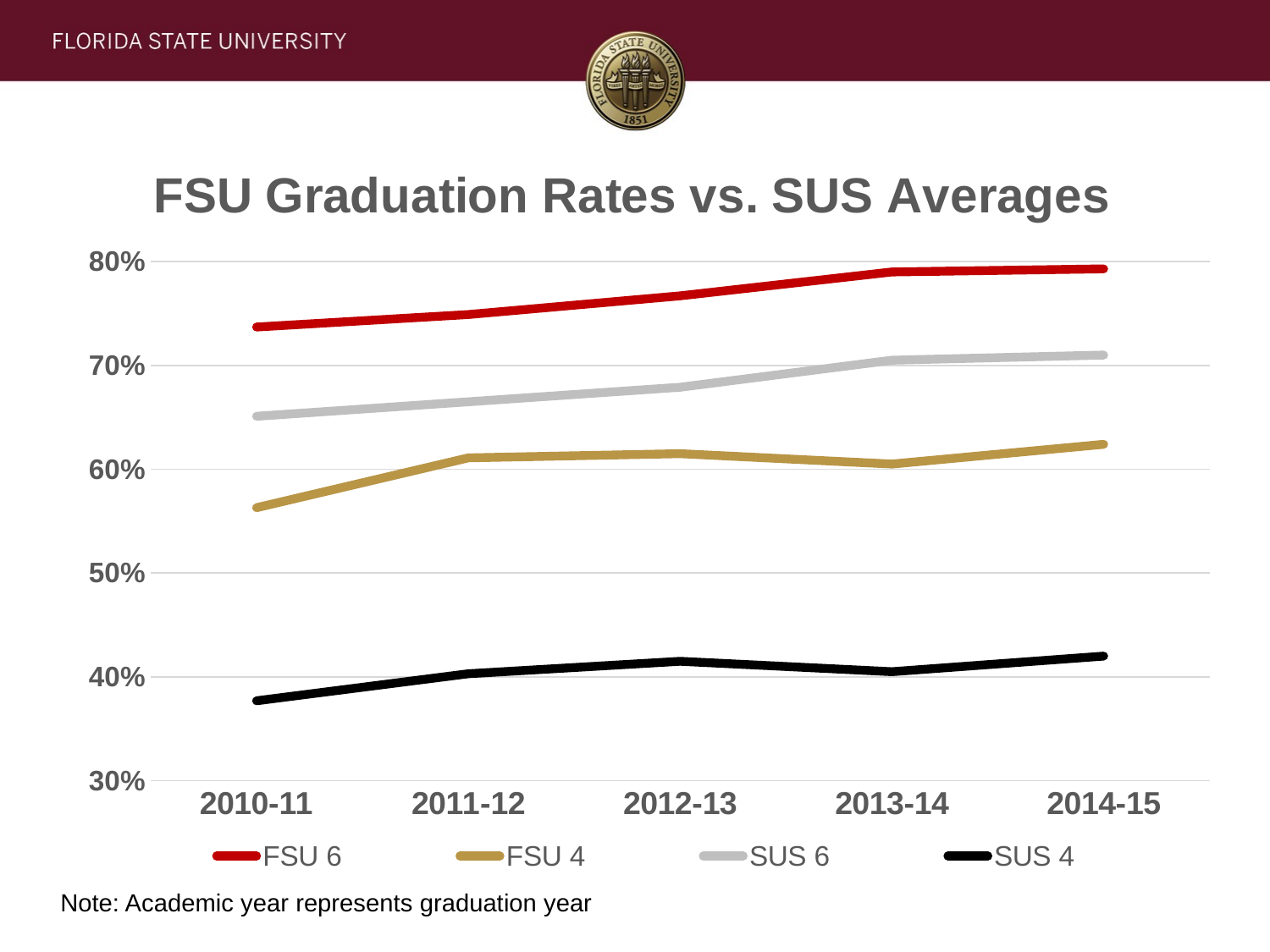
In 2014-15, which is larger: FSU 6 or SUS 6? FSU 6 How many series does the legend list? 4 Is the value for SUS 4 in 2010-11 greater or less than 40%? less Does the FSU 6 line rise or fall from 2010-11 to 2014-15? rise Which series has the lowest values across all years? SUS 4 What is the title of the chart? FSU Graduation Rates vs. SUS Averages Is the value for SUS 6 in 2010-11 greater or less than 60%? greater Is the value for FSU 4 in 2010-11 greater or less than 60%? less What kind of chart is shown on the slide? line chart Which series has the highest values across all years? FSU 6 How many academic years are plotted along the x axis? 5